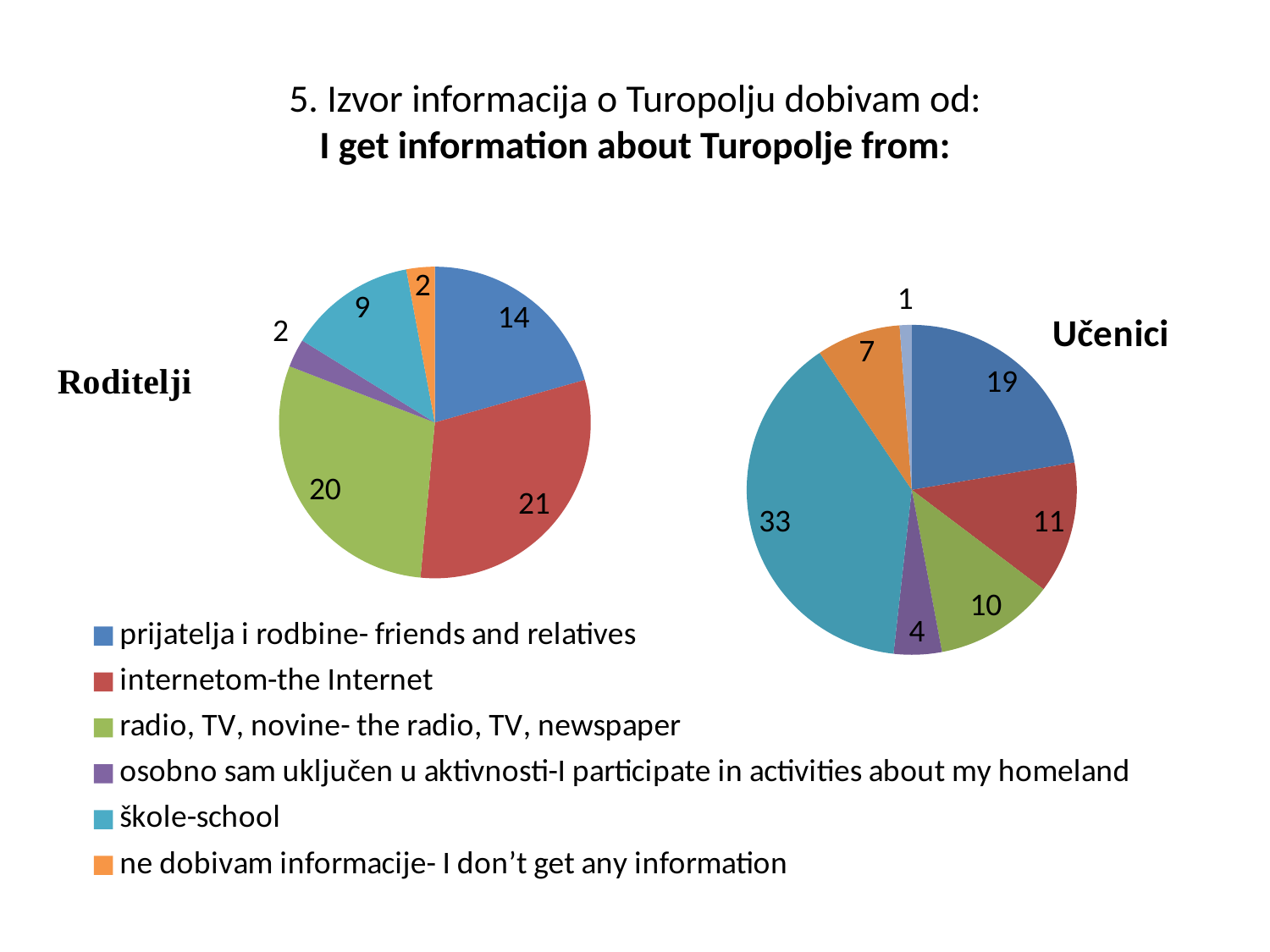
In the Učenici chart, which category has the largest slice? škole-school How many slices does the Roditelji pie chart have? 6 In the Učenici chart, what is the difference between the values for friends and relatives and the Internet? 8 In the Roditelji chart, what is the difference between the values for the Internet and radio, TV, newspaper? 1 In the Učenici chart, what is the value for škole-school? 33 In the Roditelji chart, which category has the largest slice? internetom-the Internet How many entries does the legend list? 6 What kind of charts are shown on the slide? Pie charts In the Roditelji chart, what is the value for internetom-the Internet? 21 In the Roditelji chart, which is larger: radio, TV, newspaper or friends and relatives? radio, TV, newspaper In the Roditelji chart, what is the value for škole-school? 9 In the Učenici chart, what is the value for prijatelja i rodbine- friends and relatives? 19